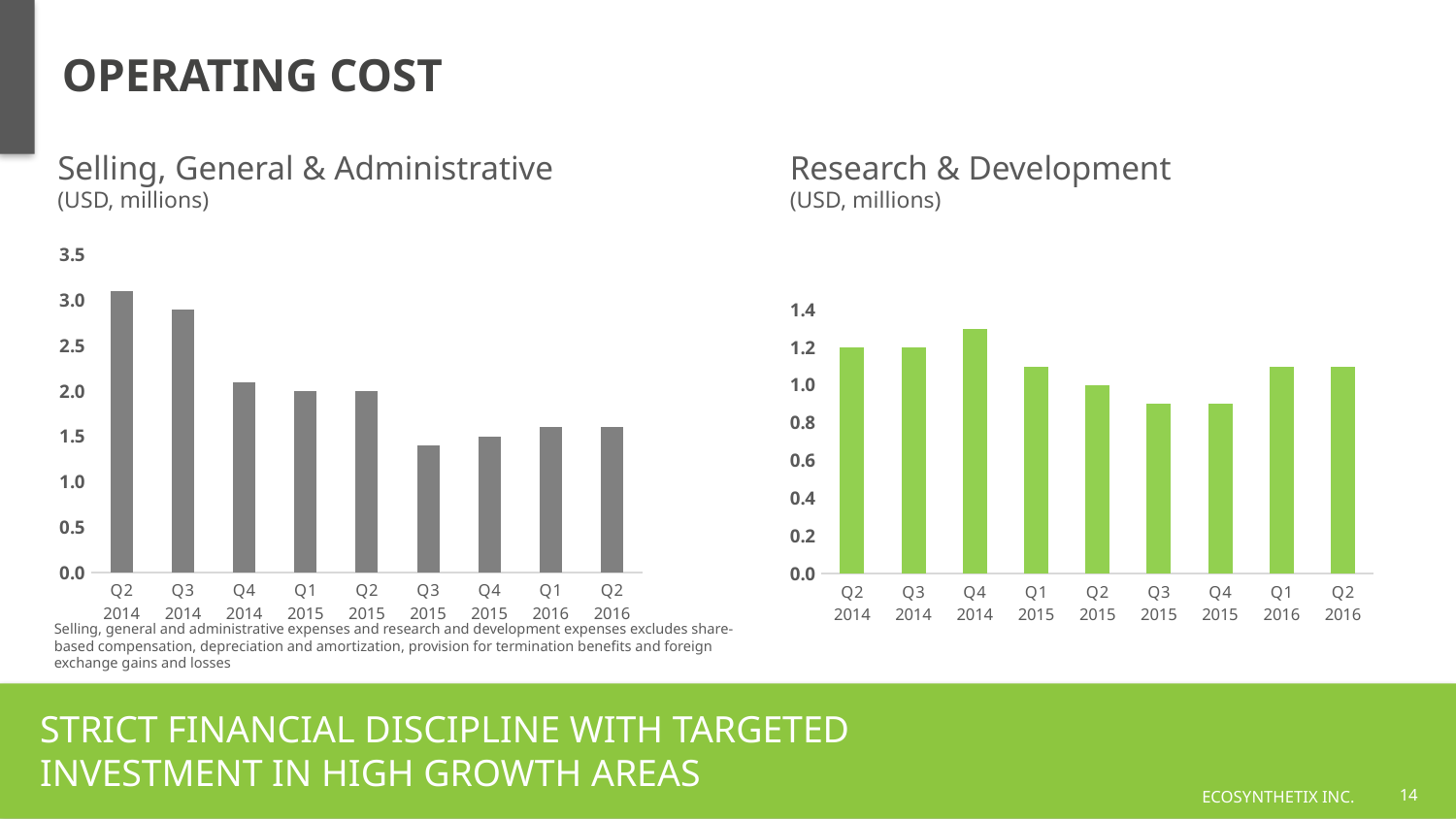
On the Selling, General & Administrative chart, which quarter has the highest value? Q2 2014 What unit is shown under the Research & Development chart title? USD, millions On the Research & Development chart, which is larger, the value for Q2 2014 or the value for Q2 2015? Q2 2014 On the Selling, General & Administrative chart, is the value for Q2 2014 greater or less than 3.0? greater On the Research & Development chart, is the value for Q4 2014 greater or less than 1.2? greater What kind of chart is the Selling, General & Administrative chart? bar chart On the Research & Development chart, is the value for Q3 2015 greater or less than 1.0? less Do the values on the Selling, General & Administrative chart generally rise or fall from Q2 2014 to Q2 2016? fall How many quarters are plotted on the Research & Development chart? 9 On the Selling, General & Administrative chart, which is larger, the value for Q3 2014 or the value for Q4 2014? Q3 2014 On the Research & Development chart, which quarter has the highest value? Q4 2014